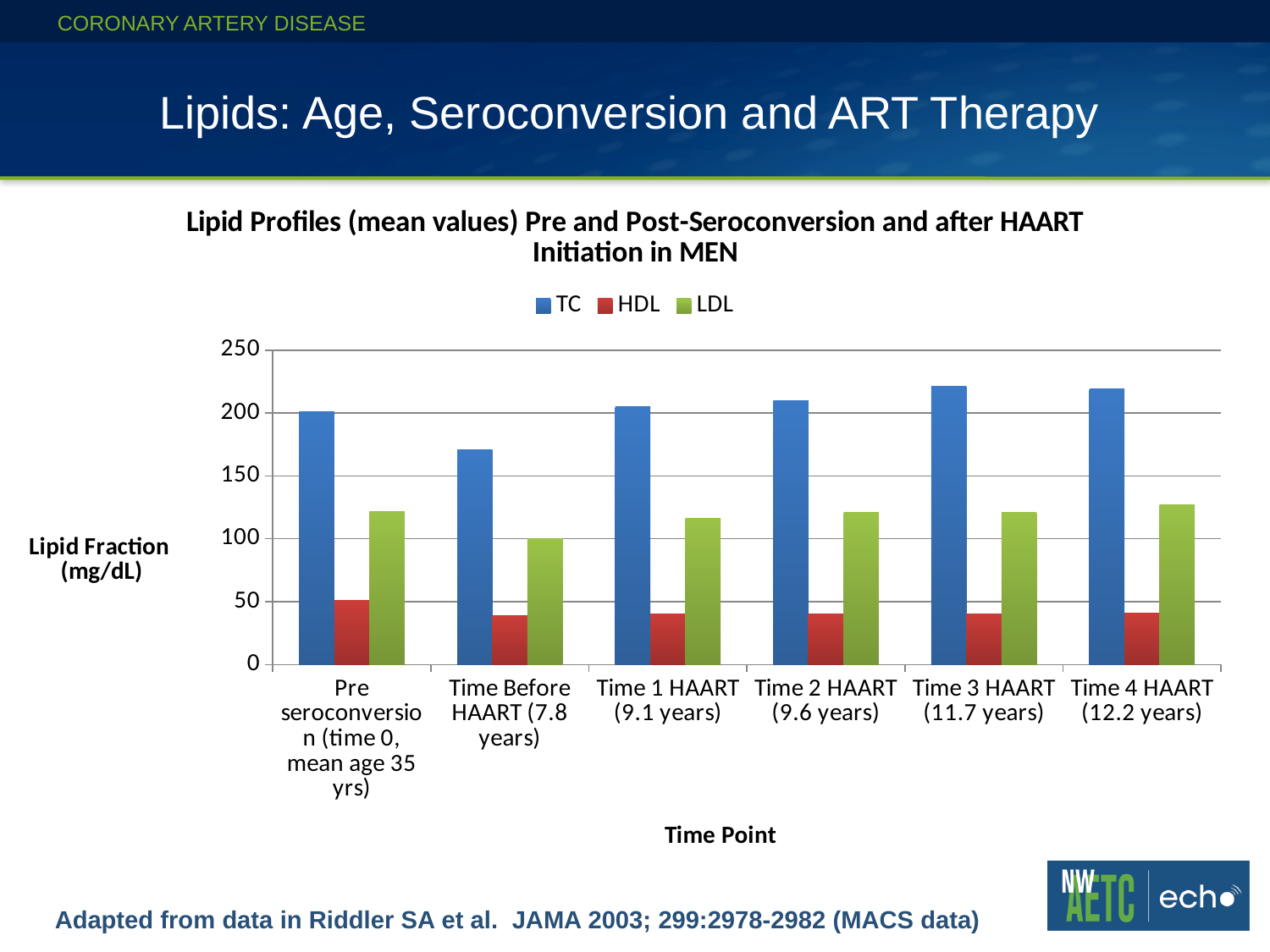
Is the TC value at Time Before HAART (7.8 years) greater or less than 200? less Is the TC value at Time 3 HAART (11.7 years) greater or less than 200? greater What kind of chart is shown on the slide? Bar chart How many series does the legend list? 3 At which time point is LDL lowest? Time Before HAART (7.8 years) Does TC rise or fall from Time Before HAART (7.8 years) to Time 3 HAART (11.7 years)? Rises What is the label on the y axis of the chart? Lipid Fraction (mg/dL) At which time point is TC lowest? Time Before HAART (7.8 years) Is the HDL value at Time 1 HAART (9.1 years) greater or less than 50? less Which is larger: TC at Time 3 HAART (11.7 years) or TC at Time Before HAART (7.8 years)? TC at Time 3 HAART (11.7 years) At which time point is HDL highest? Pre seroconversion (time 0, mean age 35 yrs) How many time points are shown along the x axis? 6